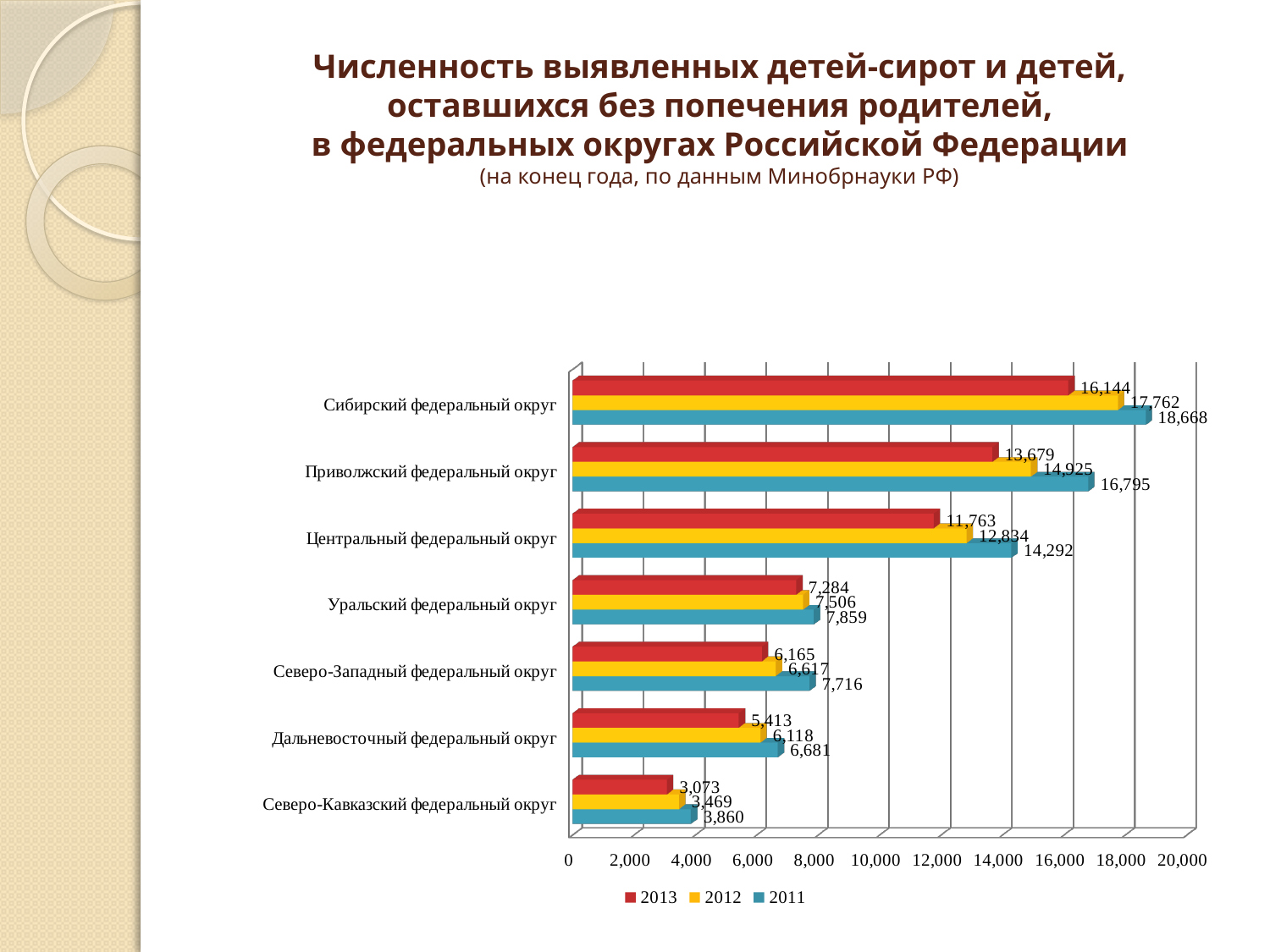
Which colour represents the 2011 series in the legend? blue How many series does the legend list? 3 Which is larger for Северо-Западный федеральный округ: the 2012 value or the 2011 value? 2011 What kind of chart is shown on the slide? bar chart How many federal districts are shown on the chart? 7 What is the 2013 value for Сибирский федеральный округ? 16,144 Is the 2013 value for Уральский федеральный округ greater or less than 8,000? less What is the difference between the 2011 and 2013 values for Приволжский федеральный округ? 3,116 Which federal district has the highest 2011 value? Сибирский федеральный округ What is the 2011 value for Центральный федеральный округ? 14,292 Which federal district has the lowest 2013 value? Северо-Кавказский федеральный округ What is the 2012 value for Дальневосточный федеральный округ? 6,118